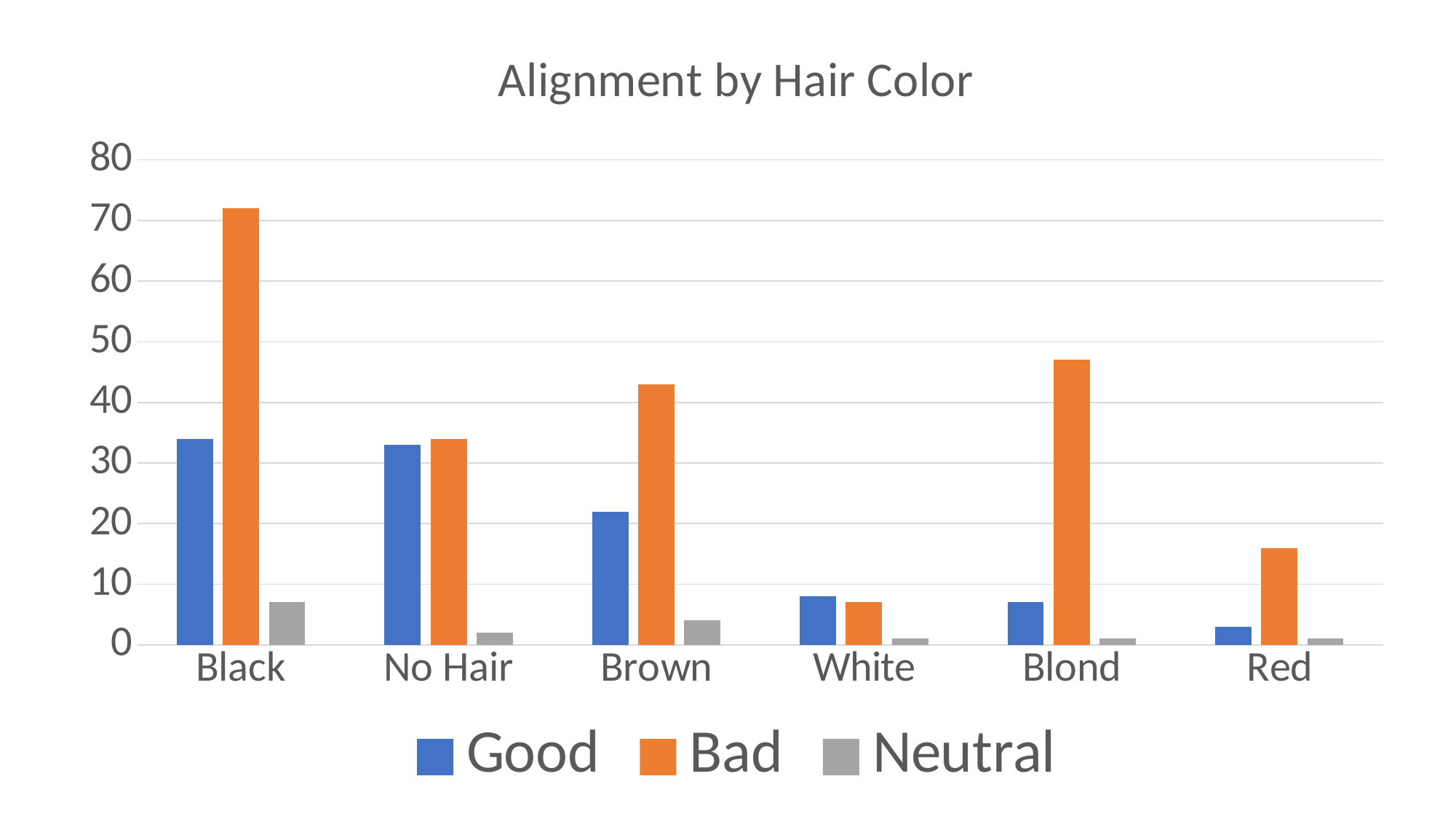
Which hair color has the highest Bad value? Black Which is larger for Red, the Good value or the Bad value? Bad Is the Bad value for Black greater or less than 70? greater What is the title of the chart? Alignment by Hair Color Which hair color has the lowest Bad value? White Which hair color has the lowest Good value? Red Is the Bad value for Blond greater or less than 40? greater What kind of chart is shown on the slide? bar chart How many hair color categories are shown on the x axis? 6 How many series does the legend list? 3 Is the Good value for Brown greater or less than 30? less Which is larger, the Good value for Black or the Good value for Brown? Black